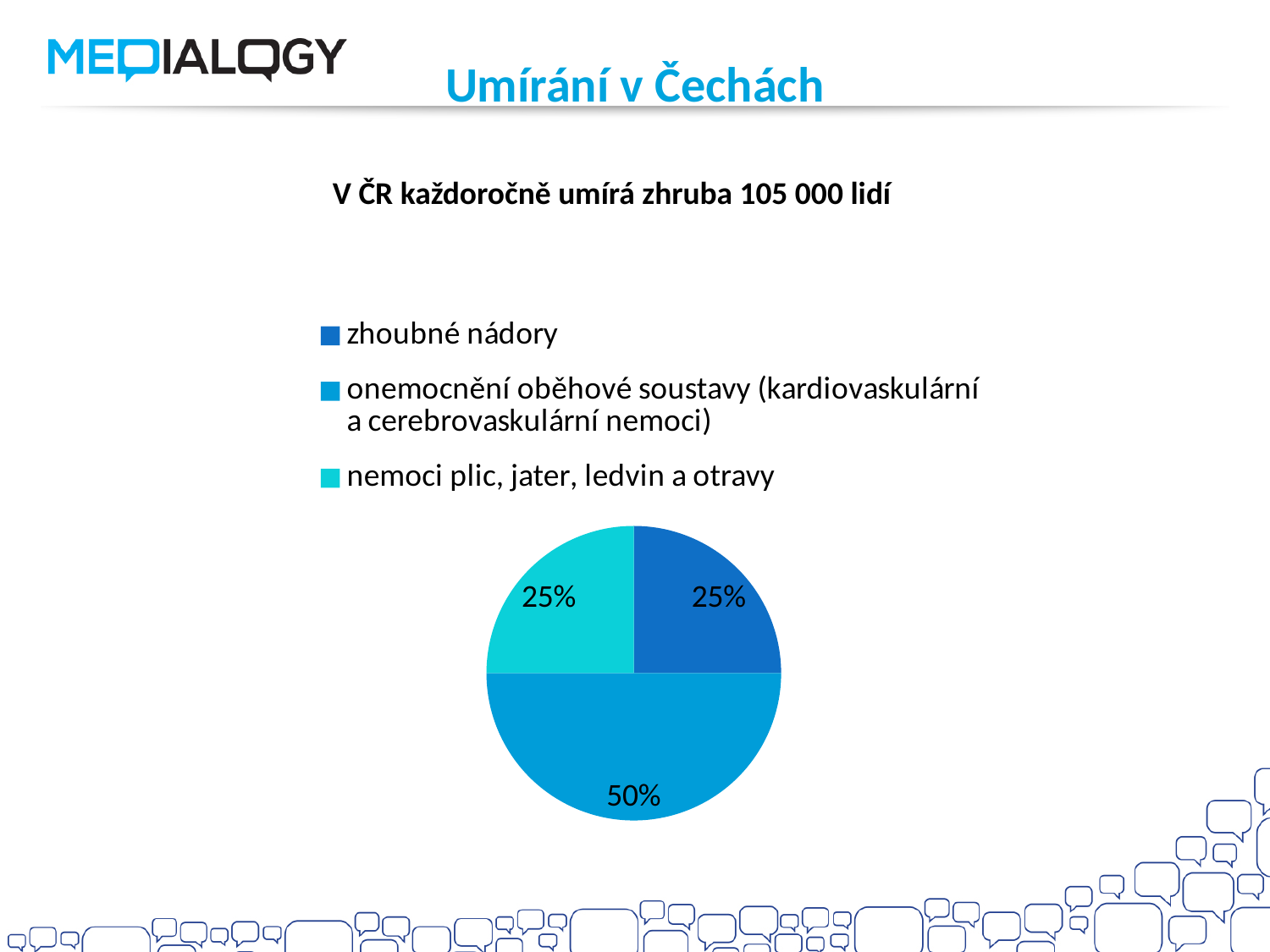
Which category has the largest slice of the pie? onemocnění oběhové soustavy (kardiovaskulární a cerebrovaskulární nemoci) What is the difference between the share for 'onemocnění oběhové soustavy' and the share for 'nemoci plic, jater, ledvin a otravy'? 25% What share of the pie does the slice for 'onemocnění oběhové soustavy (kardiovaskulární a cerebrovaskulární nemoci)' represent? 50% What share of the pie does the slice for 'zhoubné nádory' represent? 25% Which is larger: the slice for 'onemocnění oběhové soustavy' or the slice for 'zhoubné nádory'? onemocnění oběhové soustavy What kind of chart is shown on the slide? pie chart Which legend entry is shown in the lightest (cyan) colour? nemoci plic, jater, ledvin a otravy What share of the pie does the slice for 'nemoci plic, jater, ledvin a otravy' represent? 25% How many slices does the pie chart have? 3 What is the title of the slide containing the pie chart? Umírání v Čechách How many entries does the legend list? 3